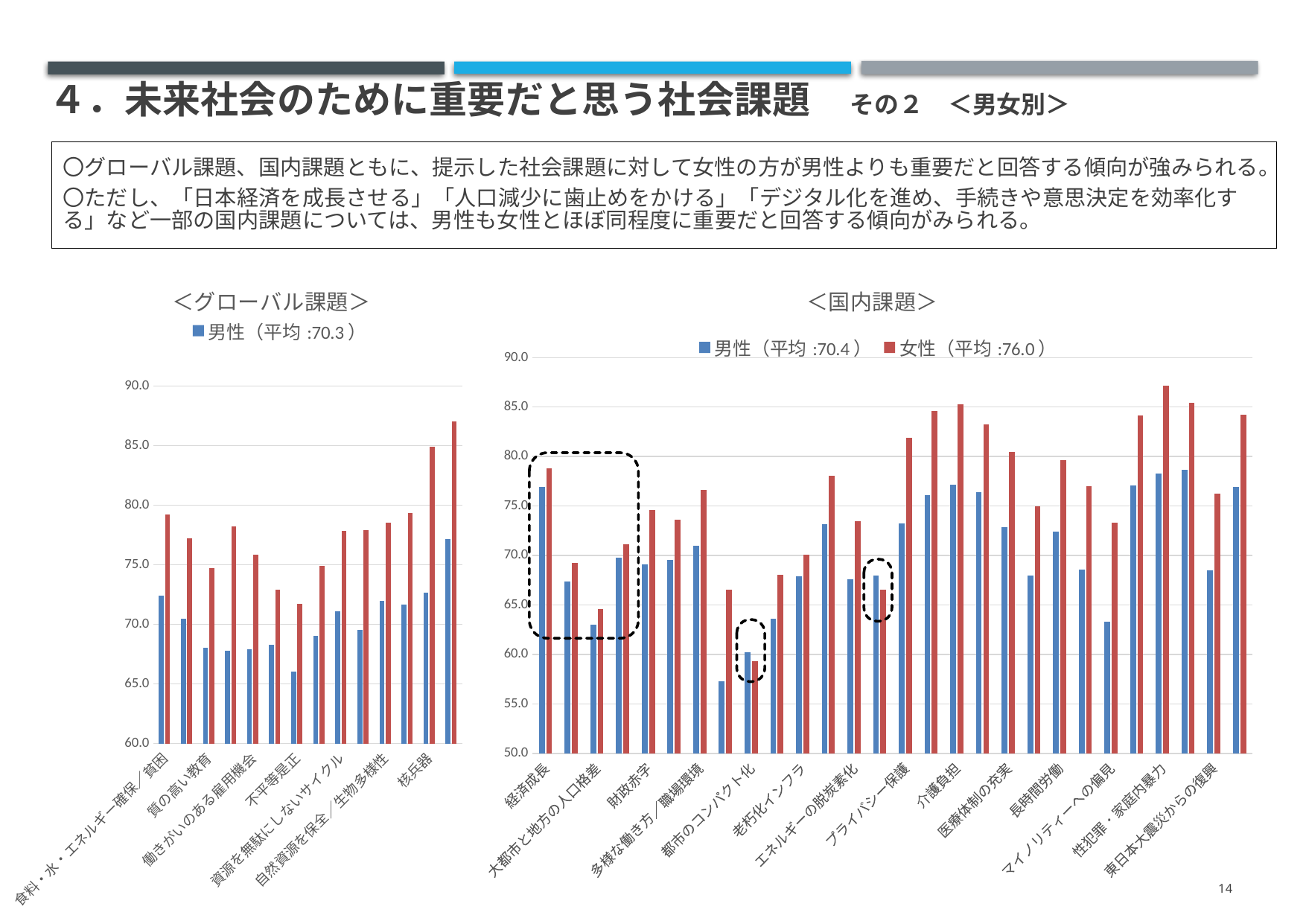
In the ＜国内課題＞ chart, is the 女性 value for 介護負担 greater or less than 80? greater In the ＜国内課題＞ chart, how many series does the legend list? 2 In the ＜国内課題＞ chart, what average value is shown in the legend for 女性? 76.0 In the ＜国内課題＞ chart, which labelled category has the highest 女性 value? 性犯罪・家庭内暴力 In the ＜国内課題＞ chart, which is larger for 介護負担, the 男性 value or the 女性 value? 女性 In the ＜国内課題＞ chart, is the 女性 value for 都市のコンパクト化 greater or less than 65? less In the ＜グローバル課題＞ chart, is the 女性 value for 食料・水・エネルギー確保／貧困 greater or less than 75? greater In the ＜グローバル課題＞ chart, what average value is shown in the legend for 男性? 70.3 What kind of chart is the ＜国内課題＞ chart? bar chart In the ＜国内課題＞ chart, which labelled category has the lowest 女性 value? 都市のコンパクト化